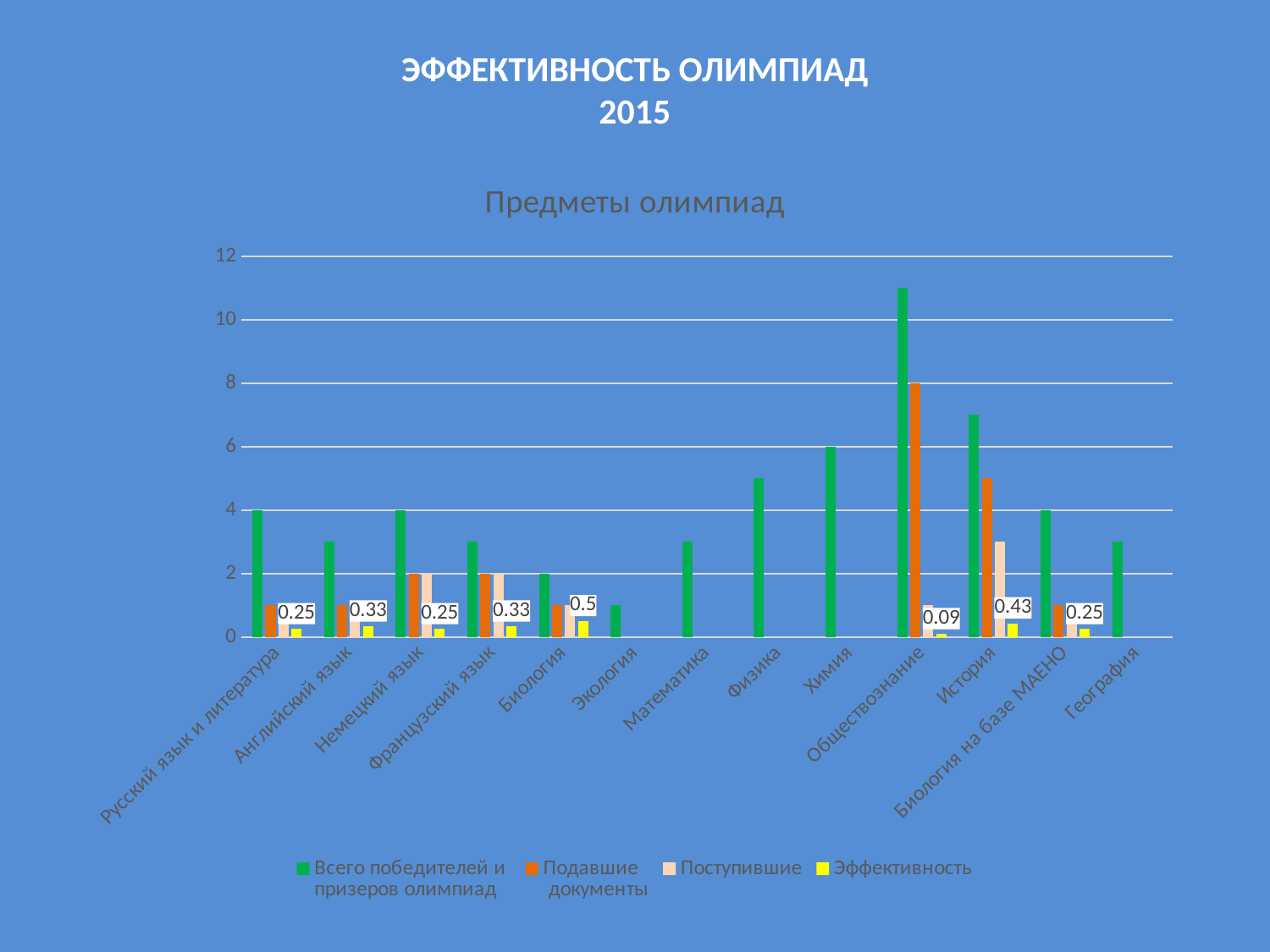
What is the difference between the Эффективность values for Биология and Обществознание? 0.41 How many series does the legend list? 4 What is the Эффективность value for История? 0.43 Which is larger, the Всего победителей и призеров олимпиад value for Химия or for Физика? Химия Which subject has the highest value for Всего победителей и призеров олимпиад? Обществознание What is the Подавшие документы value for Обществознание? 8 What is the Эффективность value for Обществознание? 0.09 Is the Всего победителей и призеров олимпиад value for Обществознание greater or less than 10? greater What is the Эффективность value for Биология? 0.5 Which subject has the lowest Эффективность value among those with a data label? Обществознание What type of chart is shown on the slide? bar chart How many subject categories are shown on the x axis? 13